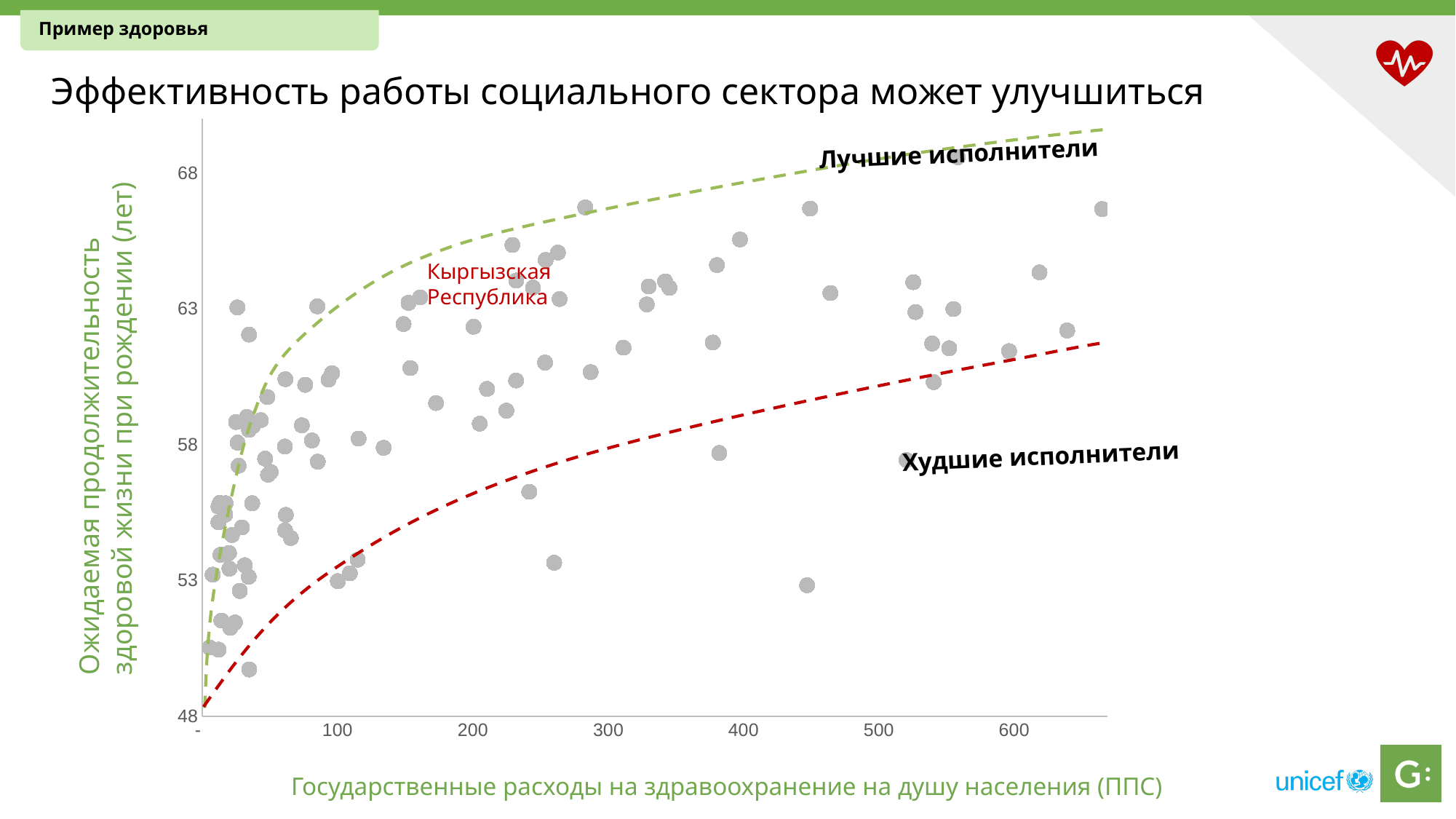
What is the highest tick value labelled on the x axis of the chart? 600 What kind of chart is shown on the slide? Scatter plot What is the title of the chart's y axis? Ожидаемая продолжительность здоровой жизни при рождении (лет) What is the title of the chart's x axis? Государственные расходы на здравоохранение на душу населения (ППС) Is the healthy life expectancy value for Кыргызская Республика greater or less than 68? less Do the plotted points generally rise or fall as government health spending per capita increases along the x axis? rise What is the lowest value shown on the y axis of the chart? 48 What does the red dashed line on the chart represent? Худшие исполнители What does the green dashed line on the chart represent? Лучшие исполнители What is the highest tick value shown on the y axis of the chart? 68 Which country is labelled in red on the chart? Кыргызская Республика Is the healthy life expectancy value for Кыргызская Республика greater or less than 58? greater